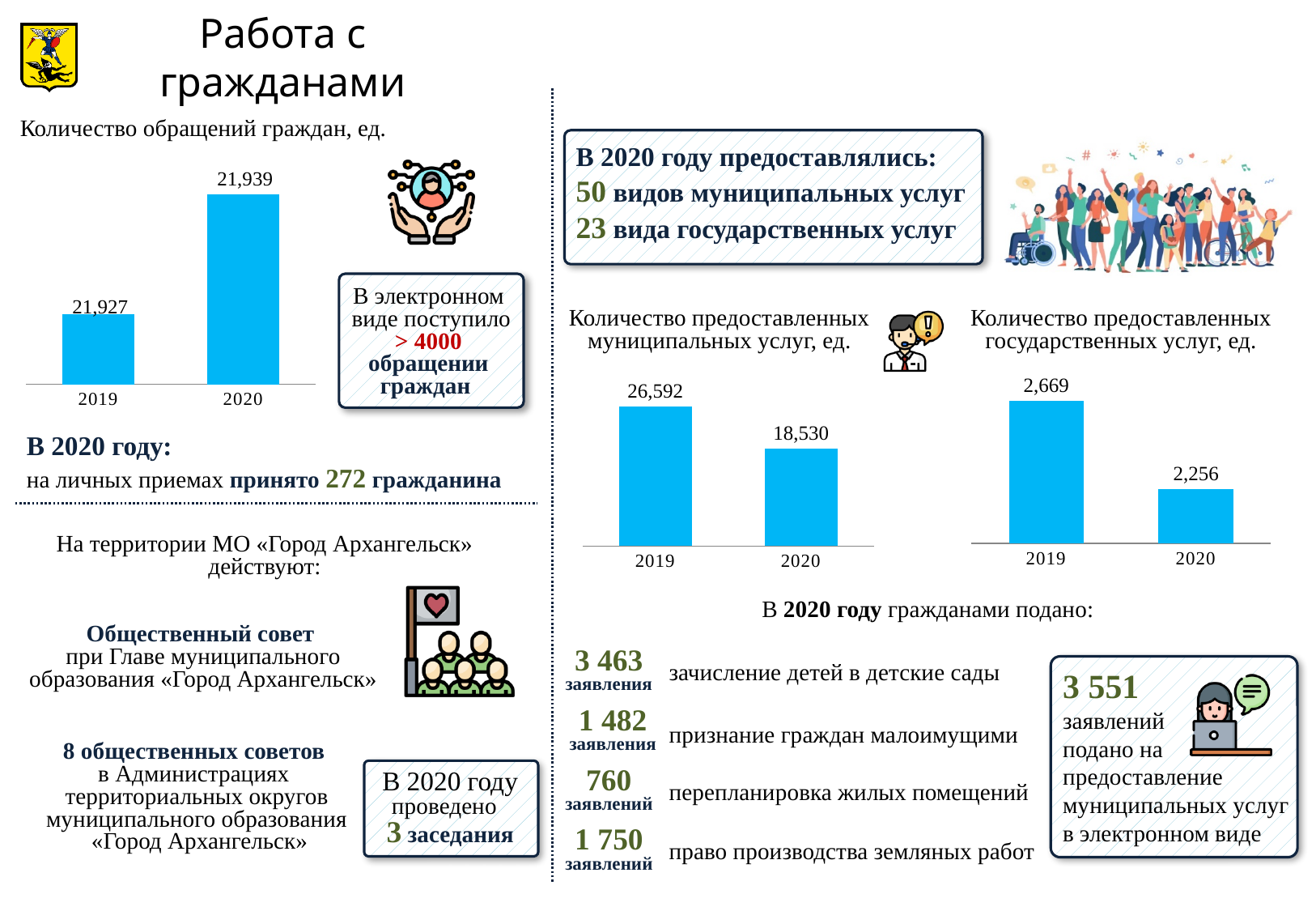
In the chart 'Количество предоставленных государственных услуг, ед.', what is the difference between the 2019 and 2020 values? 413 In the chart 'Количество предоставленных государственных услуг, ед.', what is the value for 2020? 2,256 In the chart 'Количество предоставленных муниципальных услуг, ед.', what is the value for 2020? 18,530 What type of chart is 'Количество обращений граждан, ед.'? bar chart In the chart 'Количество обращений граждан, ед.', what is the value for 2019? 21,927 In the chart 'Количество предоставленных муниципальных услуг, ед.', what is the value for 2019? 26,592 In the chart 'Количество предоставленных муниципальных услуг, ед.', by how much did the value fall from 2019 to 2020? 8,062 In the chart 'Количество обращений граждан, ед.', what is the difference between the 2020 and 2019 values? 12 In the chart 'Количество предоставленных государственных услуг, ед.', what is the value for 2019? 2,669 In the chart 'Количество предоставленных муниципальных услуг, ед.', which year has the higher value? 2019 In the chart 'Количество обращений граждан, ед.', what is the value for 2020? 21,939 In the chart 'Количество предоставленных государственных услуг, ед.', do the values rise or fall from 2019 to 2020? fall